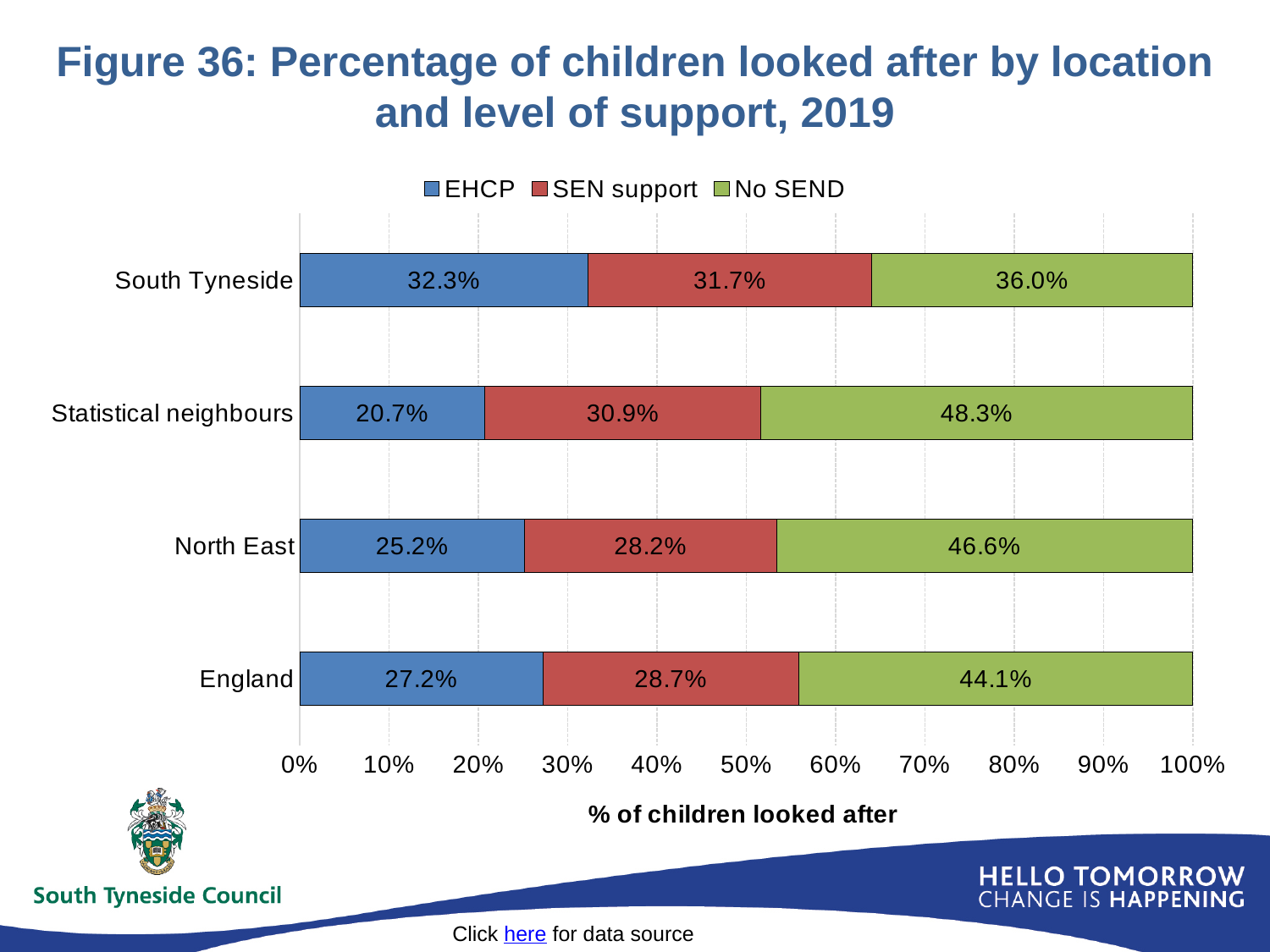
What is the No SEND value for Statistical neighbours? 48.3% How many series does the legend list? 3 Which location has the highest EHCP percentage? South Tyneside What is the No SEND value for England? 44.1% What kind of chart is shown on the slide? Stacked bar chart How many locations are shown on the chart? 4 Which location has the lowest No SEND percentage? South Tyneside What is the difference between the No SEND values for Statistical neighbours and South Tyneside? 12.3% What is the SEN support value for the North East? 28.2% What is the label on the horizontal axis? % of children looked after Which is larger, the EHCP value for England or the EHCP value for the North East? England What percentage of children looked after in South Tyneside have an EHCP? 32.3%